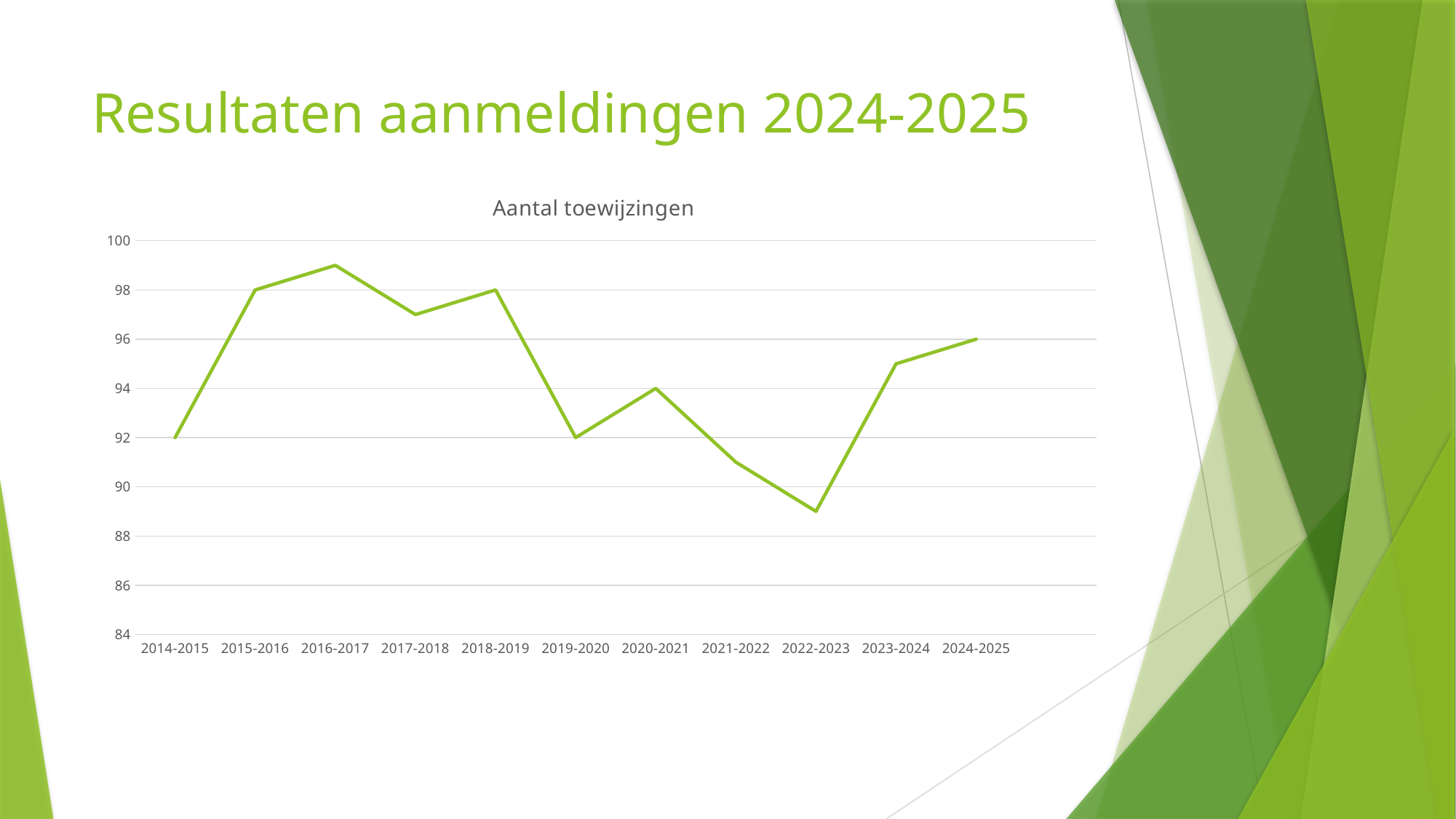
What is the difference between the values for 2015-2016 and 2014-2015? 6 What is the value for 2020-2021? 94 Which is larger, the value for 2018-2019 or the value for 2019-2020? 2018-2019 What is the value for 2014-2015? 92 Which school year has the lowest value? 2022-2023 How many school years are plotted on the x axis? 11 Which school year has the highest value? 2016-2017 What is the title of the chart? Aantal toewijzingen What is the value for 2024-2025? 96 What kind of chart is shown on the slide? line chart Is the value for 2022-2023 greater or less than 90? less Do the values rise or fall from 2022-2023 to 2024-2025? rise